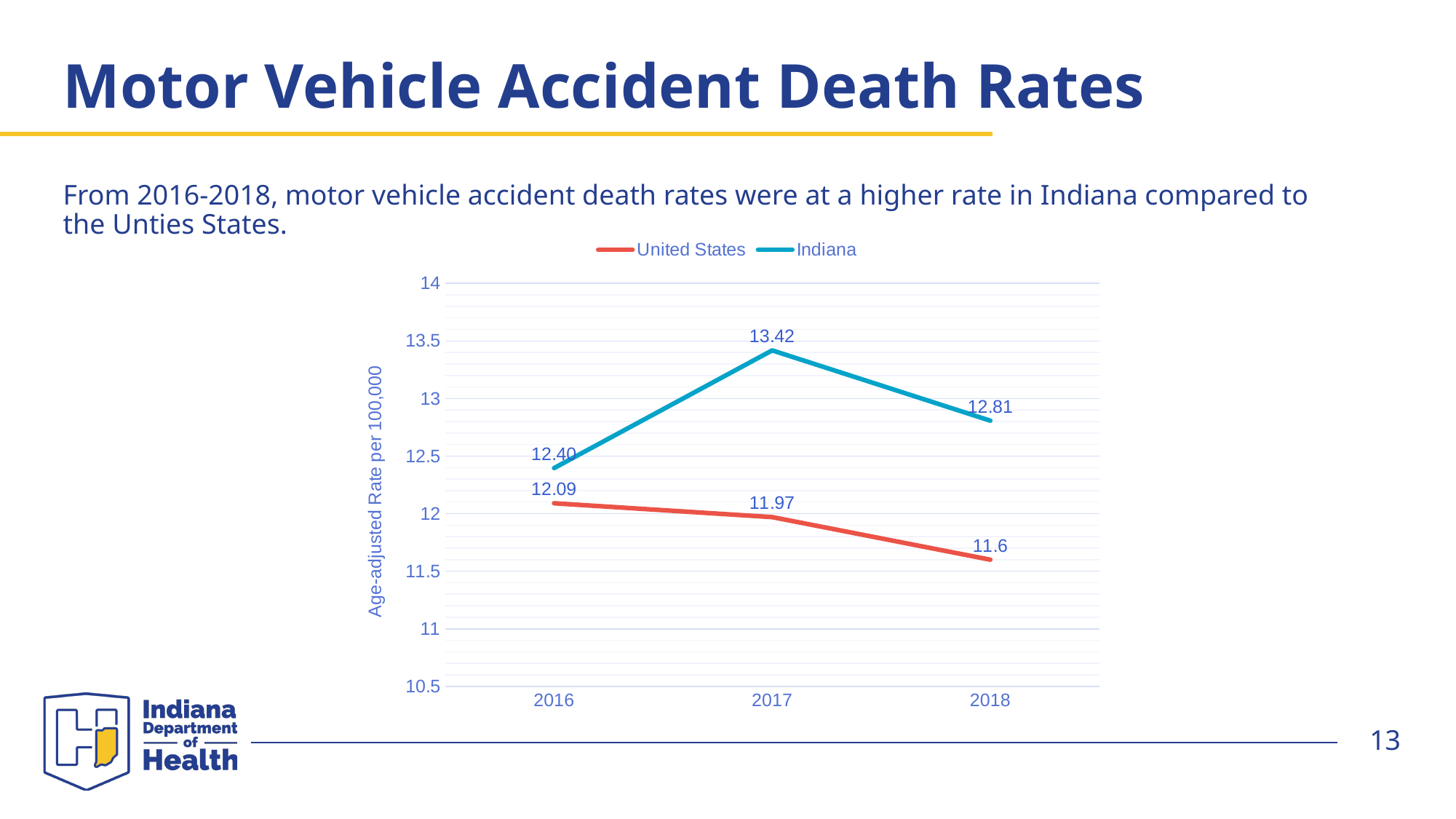
What was Indiana's age-adjusted motor vehicle accident death rate in 2017? 13.42 What kind of chart is shown on the slide? line chart Is Indiana's 2018 rate greater or less than 13? less How many series does the legend list? 2 How many years are shown on the x axis? 3 In which year was Indiana's rate highest? 2017 Which had the higher rate in 2018, Indiana or the United States? Indiana What was the United States age-adjusted motor vehicle accident death rate in 2018? 11.6 What is the difference between Indiana's and the United States' rates in 2017? 1.45 What was Indiana's rate in 2016? 12.40 Does the United States rate rise or fall from 2016 to 2018? fall In which year was the United States rate lowest? 2018